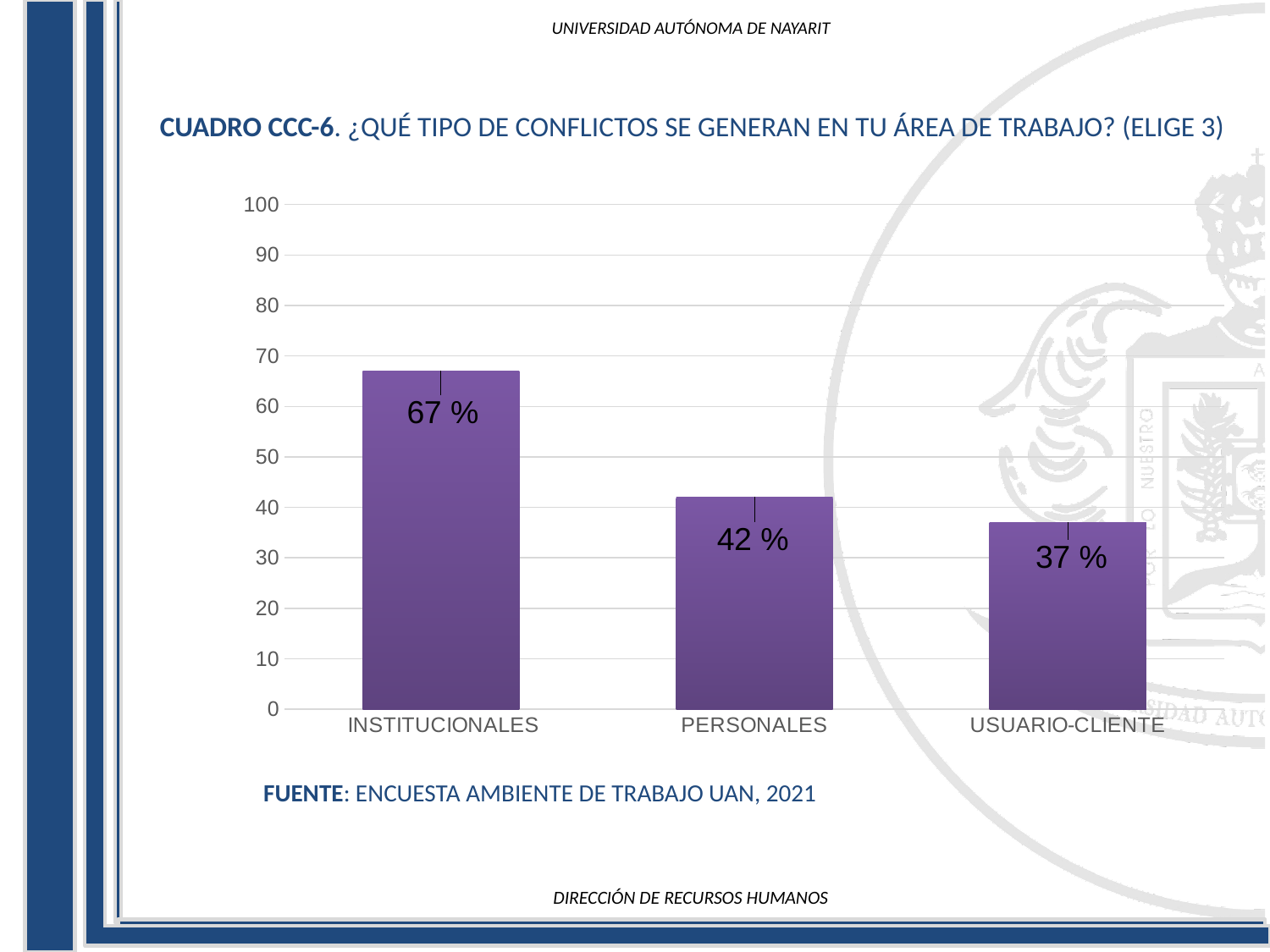
Is the value for INSTITUCIONALES greater or less than 60? greater What is the value for USUARIO-CLIENTE? 37 % Which is larger, the value for PERSONALES or the value for USUARIO-CLIENTE? PERSONALES What is the difference between the values for PERSONALES and USUARIO-CLIENTE? 5 % What is the value for PERSONALES? 42 % What kind of chart is shown on the slide? bar chart Which category has the lowest value? USUARIO-CLIENTE What is the value for INSTITUCIONALES? 67 % How many categories are shown on the x axis? 3 Do the values rise or fall from left to right along the x axis? fall Which category has the highest value? INSTITUCIONALES What is the difference between the values for INSTITUCIONALES and PERSONALES? 25 %